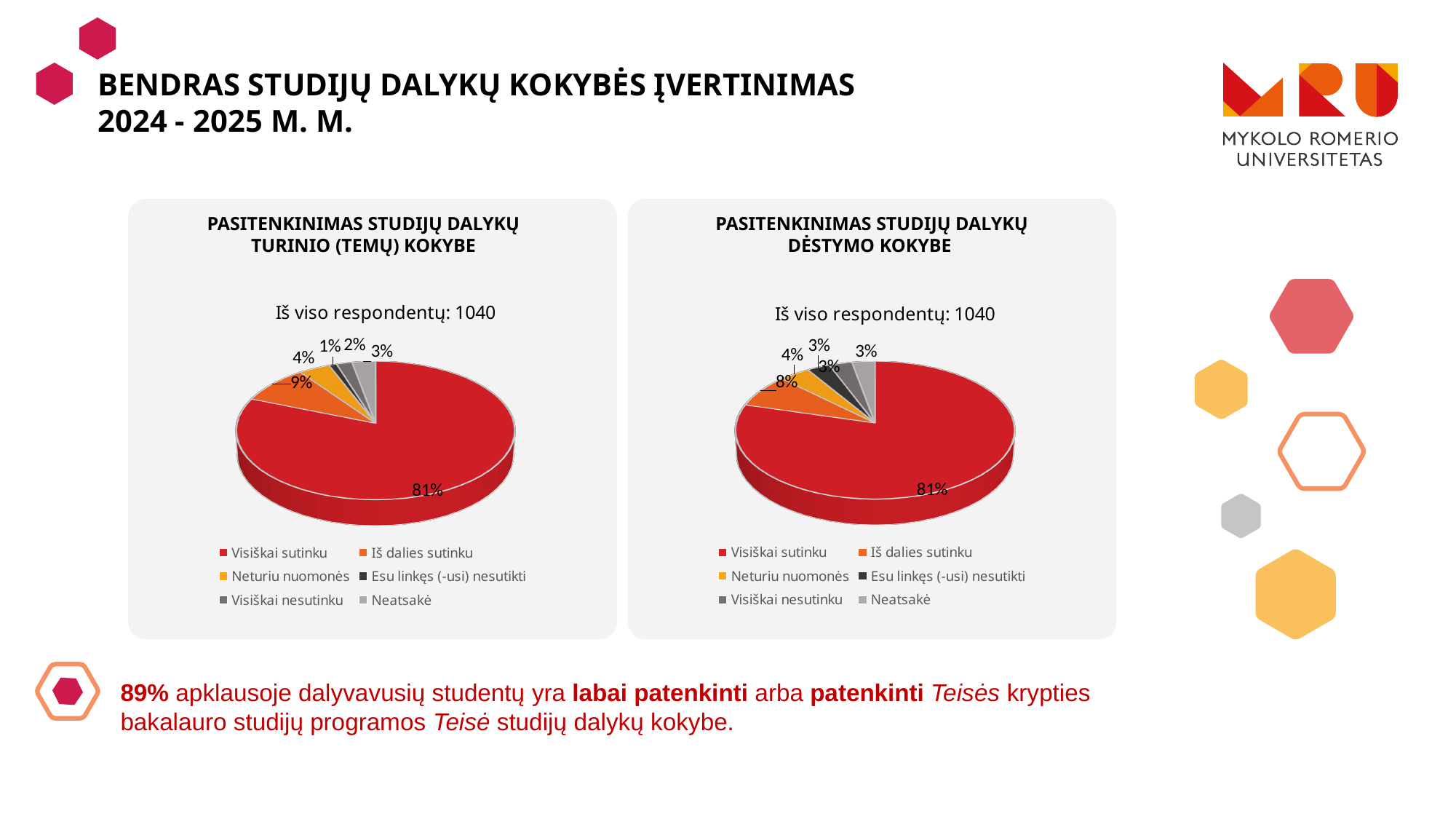
In the chart titled "PASITENKINIMAS STUDIJŲ DALYKŲ DĖSTYMO KOKYBE", what percentage is shown for "Iš dalies sutinku"? 8% What colour is the "Visiškai sutinku" slice in the right chart? Red How many categories does the legend of the right chart list? 6 In the chart titled "PASITENKINIMAS STUDIJŲ DALYKŲ TURINIO (TEMŲ) KOKYBE", what percentage is shown for "Visiškai sutinku"? 81% What kind of chart is used in the chart titled "PASITENKINIMAS STUDIJŲ DALYKŲ DĖSTYMO KOKYBE"? Pie chart In the right chart, which is larger: "Iš dalies sutinku" or "Neturiu nuomonės"? Iš dalies sutinku In the chart titled "PASITENKINIMAS STUDIJŲ DALYKŲ TURINIO (TEMŲ) KOKYBE", what percentage is shown for "Iš dalies sutinku"? 9% How many respondents in total are reported for the left chart? 1040 In the chart titled "PASITENKINIMAS STUDIJŲ DALYKŲ DĖSTYMO KOKYBE", what percentage is shown for "Neturiu nuomonės"? 4% What is the difference in percentage points between "Visiškai sutinku" and "Iš dalies sutinku" in the left chart? 72 In the left chart, which category has the smallest share of the pie? Esu linkęs (-usi) nesutikti In the left chart, which category has the largest share of the pie? Visiškai sutinku